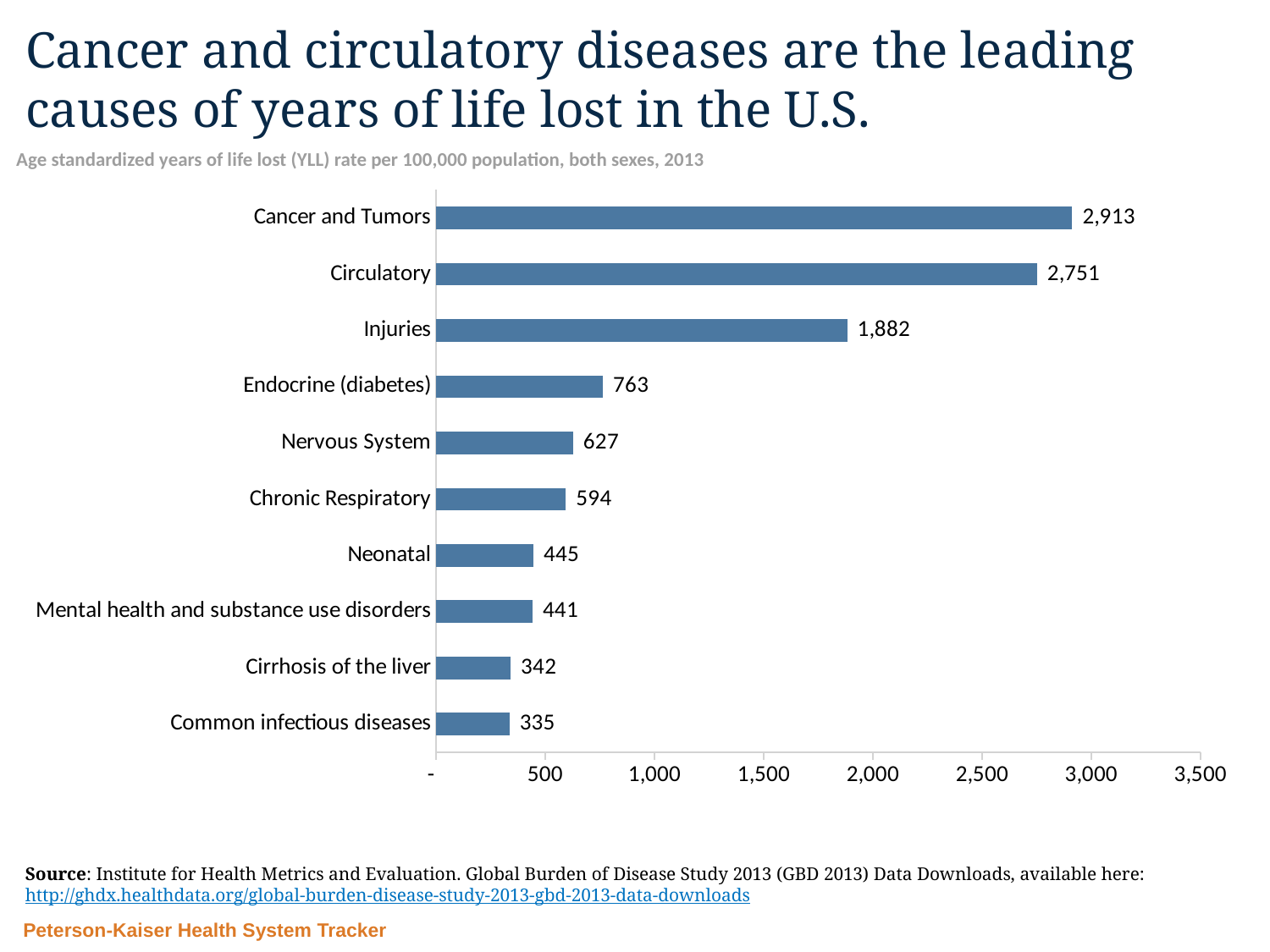
What is the subtitle describing the measure plotted in the chart? Age standardized years of life lost (YLL) rate per 100,000 population, both sexes, 2013 What is the difference between the YLL rates for Endocrine (diabetes) and Chronic Respiratory? 169 Which cause has the highest YLL rate? Cancer and Tumors What is the YLL rate per 100,000 population for Nervous System? 627 Which has a higher YLL rate, Injuries or Endocrine (diabetes)? Injuries What kind of chart is shown on the slide? Bar chart Which cause has the lowest YLL rate? Common infectious diseases What is the YLL rate per 100,000 population for Injuries? 1,882 What is the difference between the YLL rates for Cancer and Tumors and Circulatory? 162 What is the YLL rate per 100,000 population for Cancer and Tumors? 2,913 What is the YLL rate per 100,000 population for Cirrhosis of the liver? 342 How many causes are shown in the chart? 10